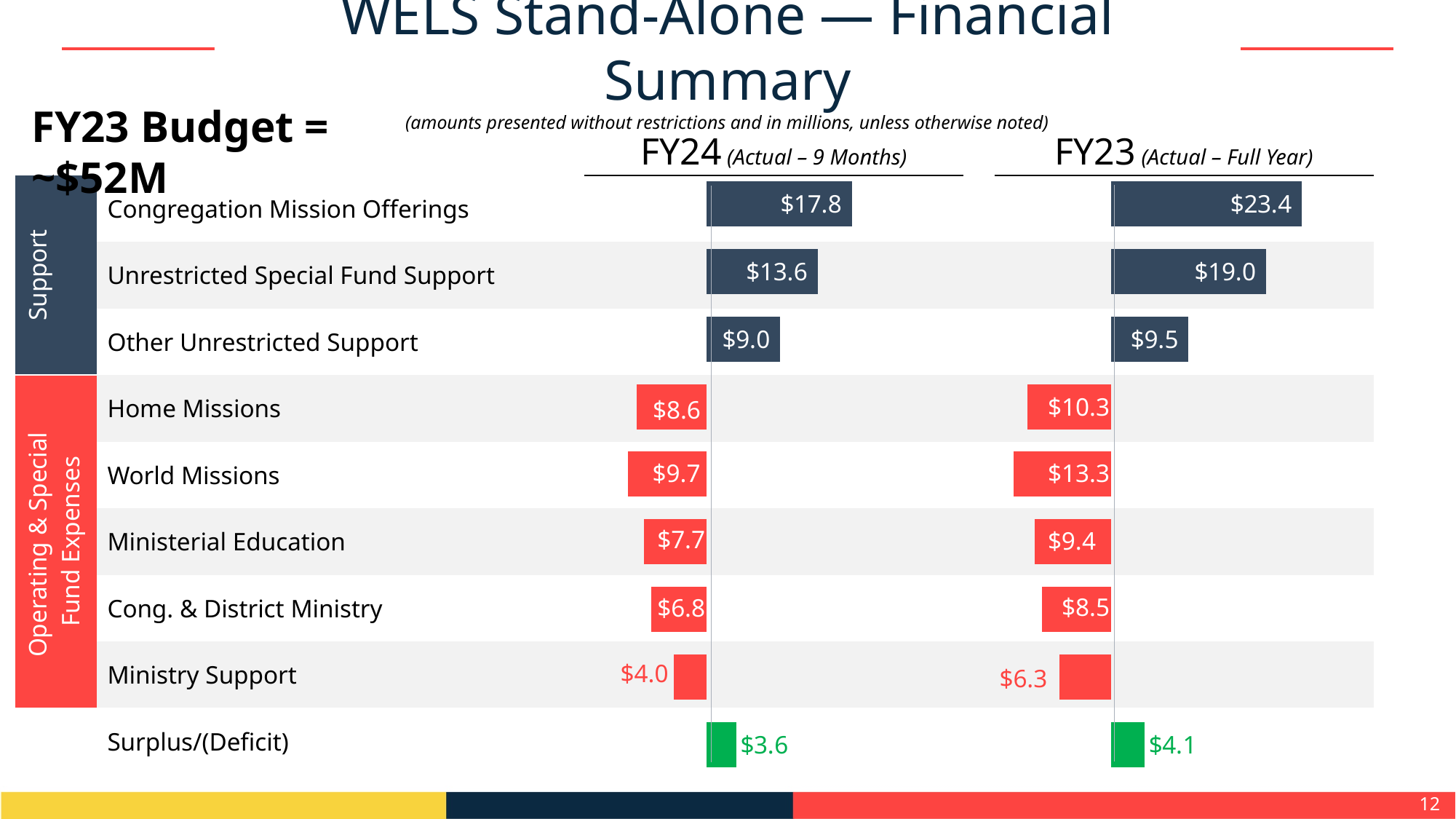
In the FY23 (Actual – Full Year) chart, which is larger: Home Missions or World Missions? World Missions In the FY24 (Actual – 9 Months) chart, what is the difference between Home Missions and Ministerial Education? $0.9 What is the difference between Congregation Mission Offerings in the FY23 (Actual – Full Year) chart and in the FY24 (Actual – 9 Months) chart? $5.6 In the FY24 (Actual – 9 Months) chart, what is the value for World Missions? $9.7 In the FY24 (Actual – 9 Months) chart, which of the Operating & Special Fund Expenses categories has the lowest value? Ministry Support In the FY23 (Actual – Full Year) chart, what is the Surplus/(Deficit) value? $4.1 What kind of chart is used for the FY23 (Actual – Full Year) data? Bar chart How many categories are shown in the FY24 (Actual – 9 Months) chart? 9 In the FY23 (Actual – Full Year) chart, what is the value for Unrestricted Special Fund Support? $19.0 In the FY24 (Actual – 9 Months) chart, what colour are the bars for the Operating & Special Fund Expenses categories? Red In the FY23 (Actual – Full Year) chart, which category has the highest value? Congregation Mission Offerings In the FY24 (Actual – 9 Months) chart, what is the value for Congregation Mission Offerings? $17.8